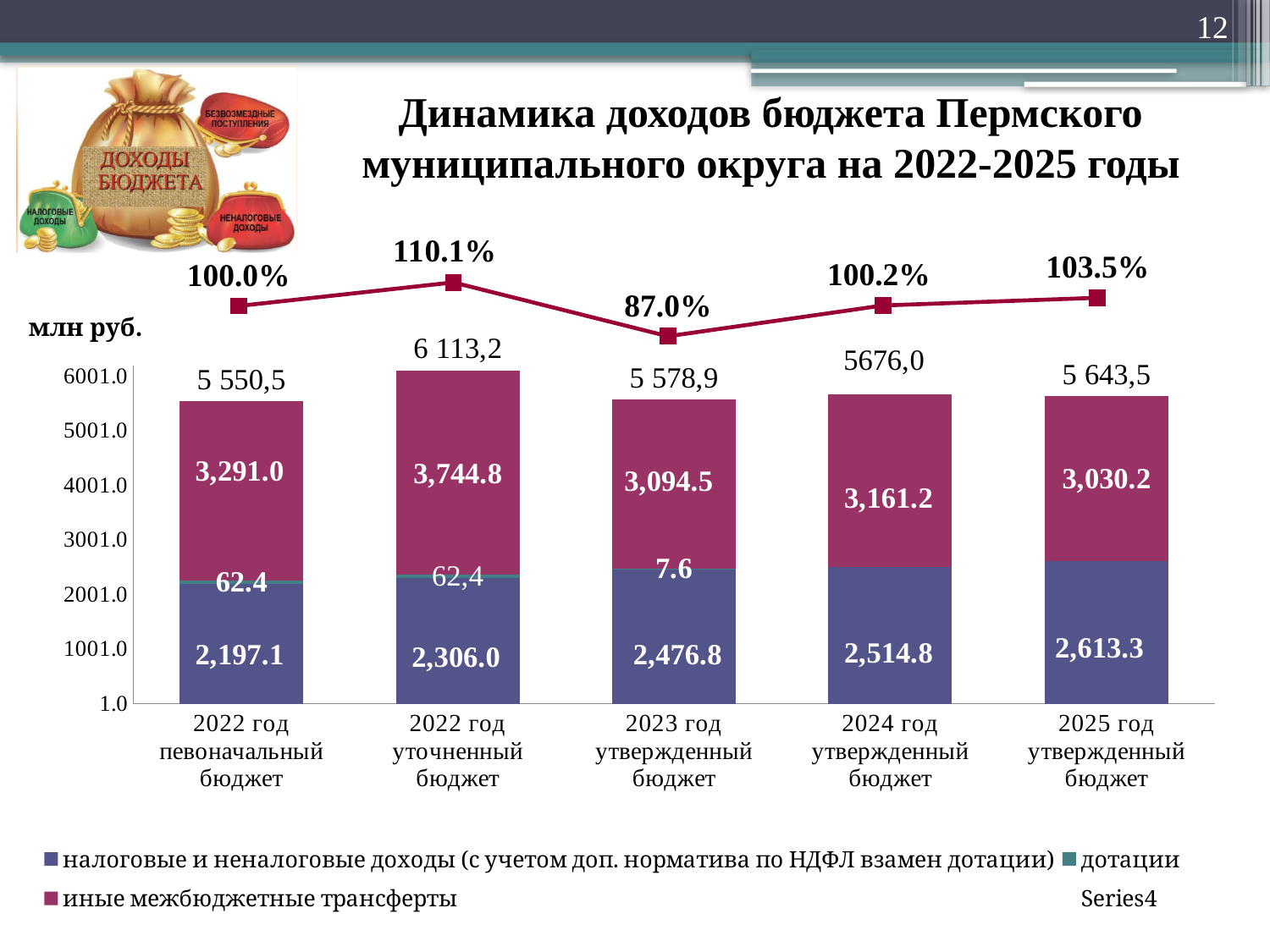
What unit is indicated for the bar values on the chart? млн руб. What is the value of дотации for 2023 год утвержденный бюджет? 7.6 Which is larger: иные межбюджетные трансферты for 2023 год утвержденный бюджет or for 2024 год утвержденный бюджет? 2024 год утвержденный бюджет How many categories are shown on the x axis? 5 What is the value of иные межбюджетные трансферты for 2022 год уточненный бюджет? 3,744.8 What is the value of налоговые и неналоговые доходы for 2025 год утвержденный бюджет? 2,613.3 How many series does the legend list? 4 Which category has the highest percentage on the line? 2022 год уточненный бюджет What percentage is shown on the line for 2023 год утвержденный бюджет? 87.0% Which category has the lowest value of налоговые и неналоговые доходы? 2022 год певоначальный бюджет What total is printed above the bar for 2024 год утвержденный бюджет? 5676,0 What is the difference in налоговые и неналоговые доходы between 2025 год утвержденный бюджет and 2024 год утвержденный бюджет? 98.5